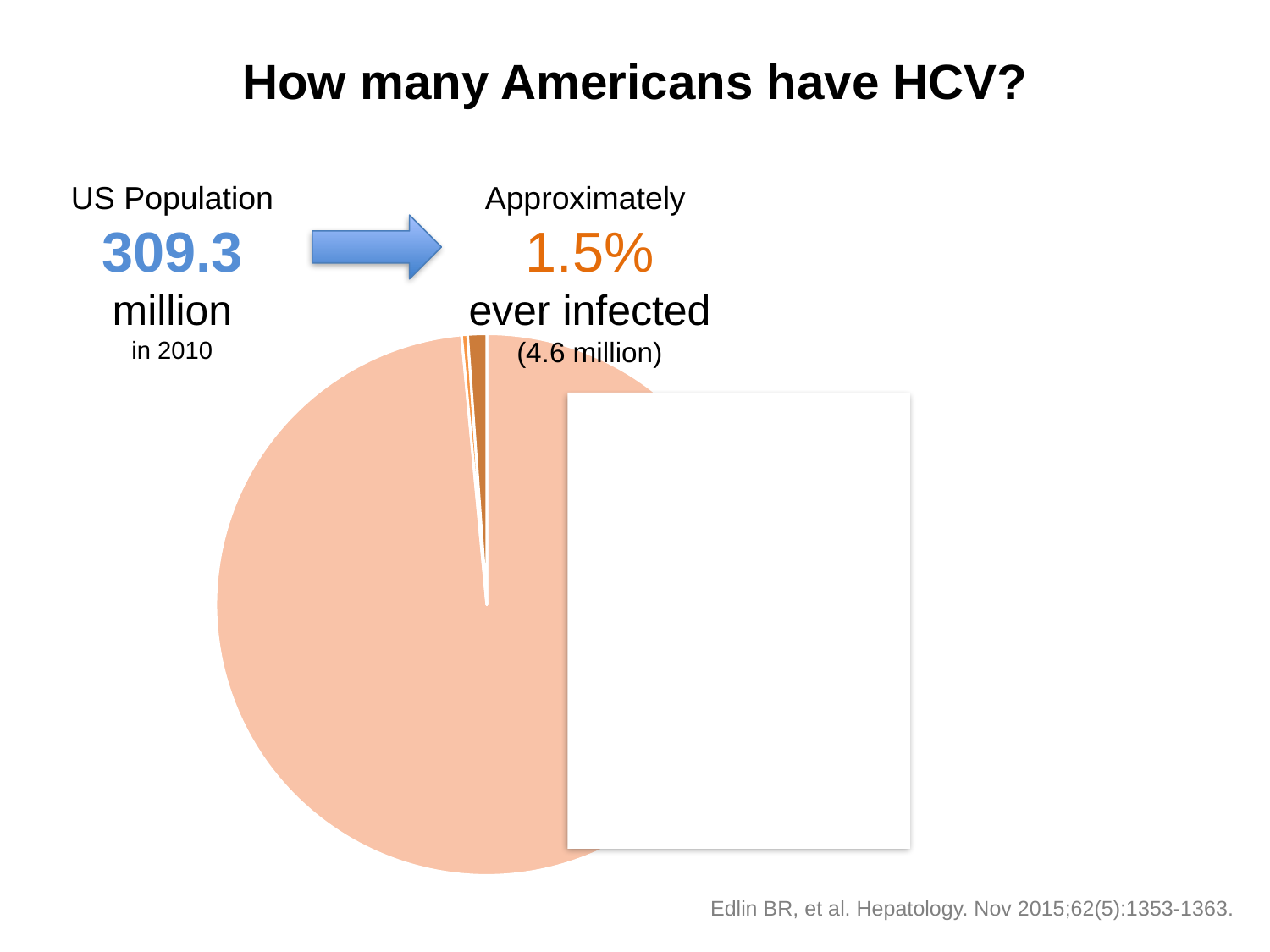
What was the US population in 2010 according to the slide? 309.3 million What colour is the pie slice representing Americans ever infected with HCV? dark orange According to the slide, what share of the US population has ever been infected with HCV? 1.5% How many Americans does the slide say have ever been infected with HCV? 4.6 million What kind of chart is shown on the slide? pie chart Which slice of the pie chart is larger, the dark orange slice or the light orange slice? the light orange slice What year does the US population figure on the slide refer to? 2010 What is the title of the slide? How many Americans have HCV?